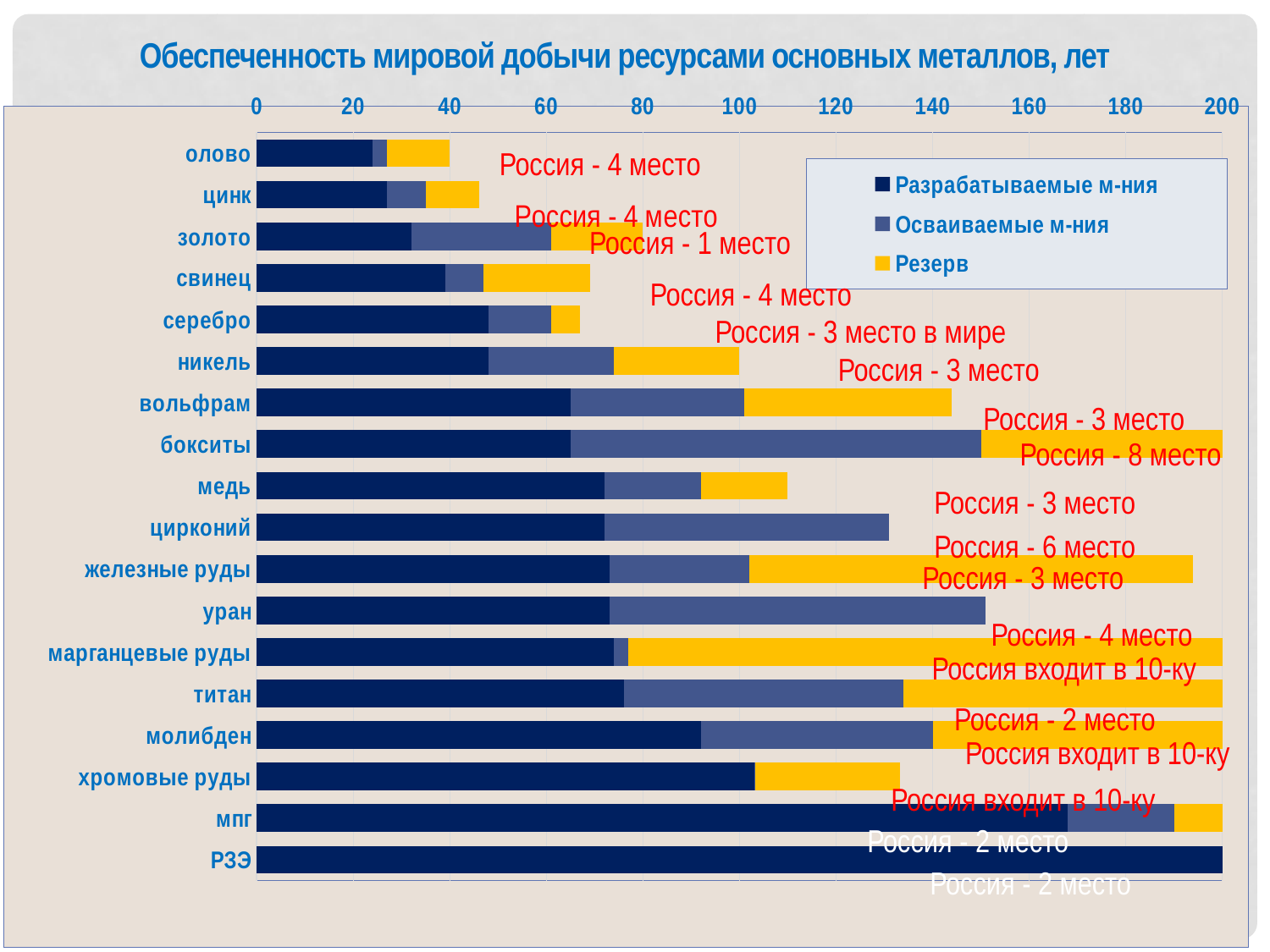
Is the total bar length for медь greater or less than 100? greater How many series does the legend list? 3 Which has the longer total bar, вольфрам or медь? вольфрам Which has the longer total bar, никель or серебро? никель What is the title of the chart? Обеспеченность мировой добычи ресурсами основных металлов, лет How many metal categories are plotted on the chart? 18 Which category has the shortest total bar on the chart? олово Is the 'Разрабатываемые м-ния' value for РЗЭ greater or less than 180? greater Which colour represents the series 'Резерв' in the legend? Yellow What kind of chart is shown on the slide? Stacked bar chart Is the total bar length for олово greater or less than 60? less